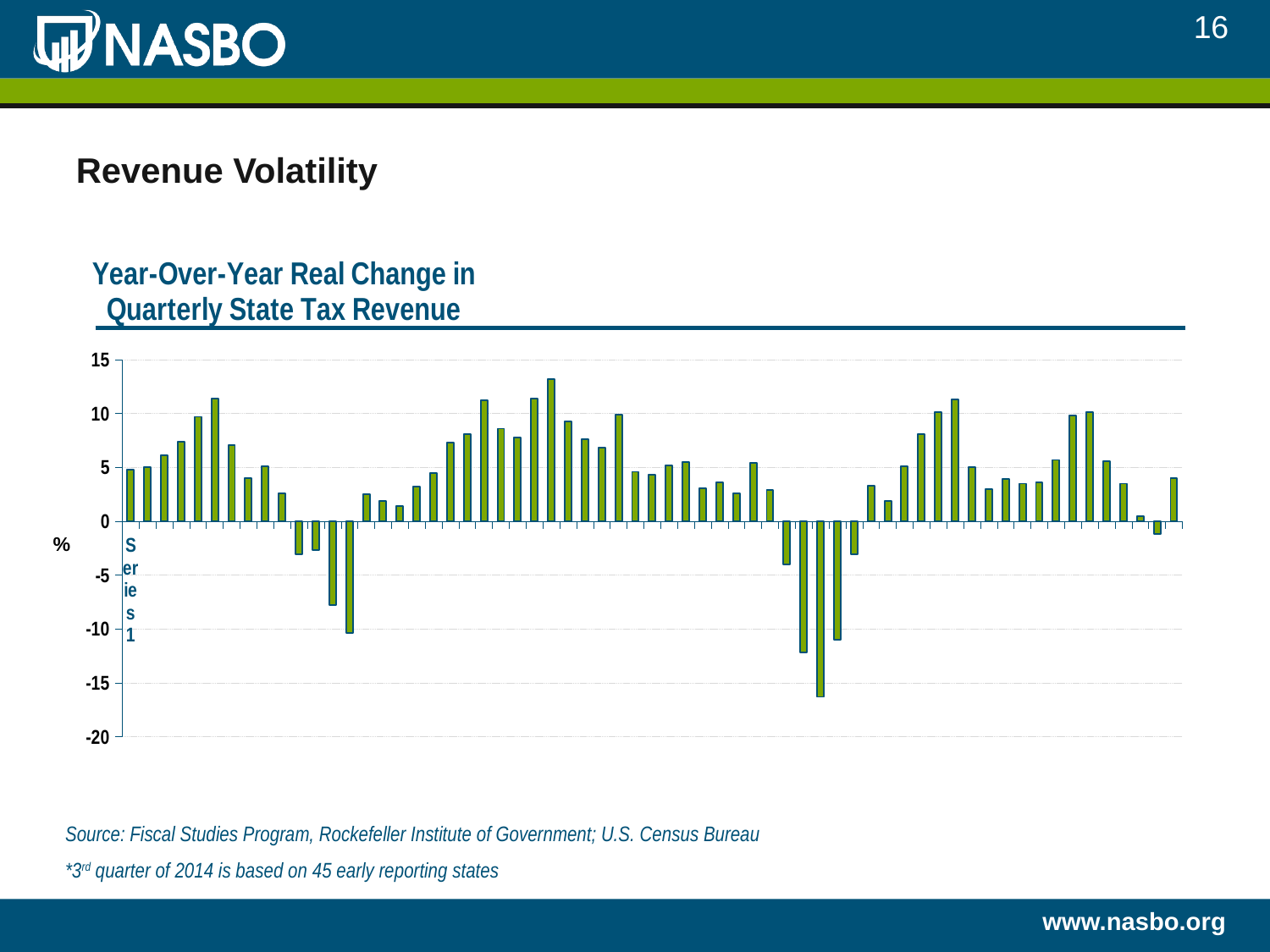
What unit is shown on the vertical axis of the chart? % Is the lowest bar on the chart greater or less than -15? less Is the highest bar on the chart greater or less than 10? greater What is the title of the chart? Year-Over-Year Real Change in Quarterly State Tax Revenue What is the highest value shown on the vertical axis of the chart? 15 What is the lowest value shown on the vertical axis of the chart? -20 Is the highest bar on the chart greater or less than 15? less What kind of chart is shown on the slide? bar chart